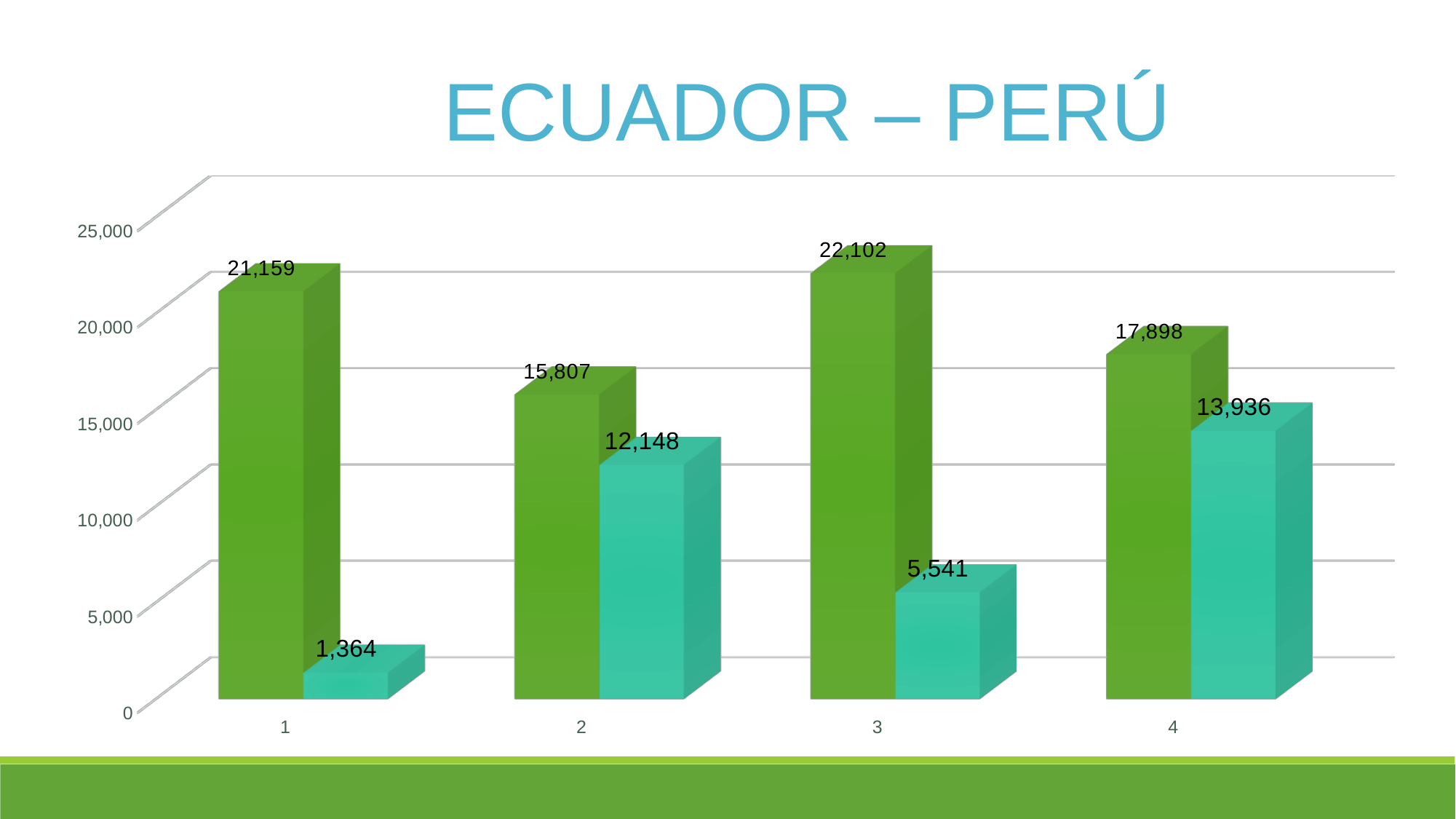
Which category has the lowest teal bar? 1 Which category has the highest green bar? 3 What is the difference between the green and teal bars for category 3? 16,561 What is the value of the green bar for category 3? 22,102 What is the value of the green bar for category 2? 15,807 Which is larger, the teal bar for category 2 or the teal bar for category 3? category 2 What is the title of the chart? ECUADOR – PERÚ What is the value of the teal bar for category 4? 13,936 What is the value of the teal bar for category 1? 1,364 What kind of chart is shown on the slide? bar chart How many categories are shown on the x axis? 4 What is the difference between the green bars for category 1 and category 4? 3,261